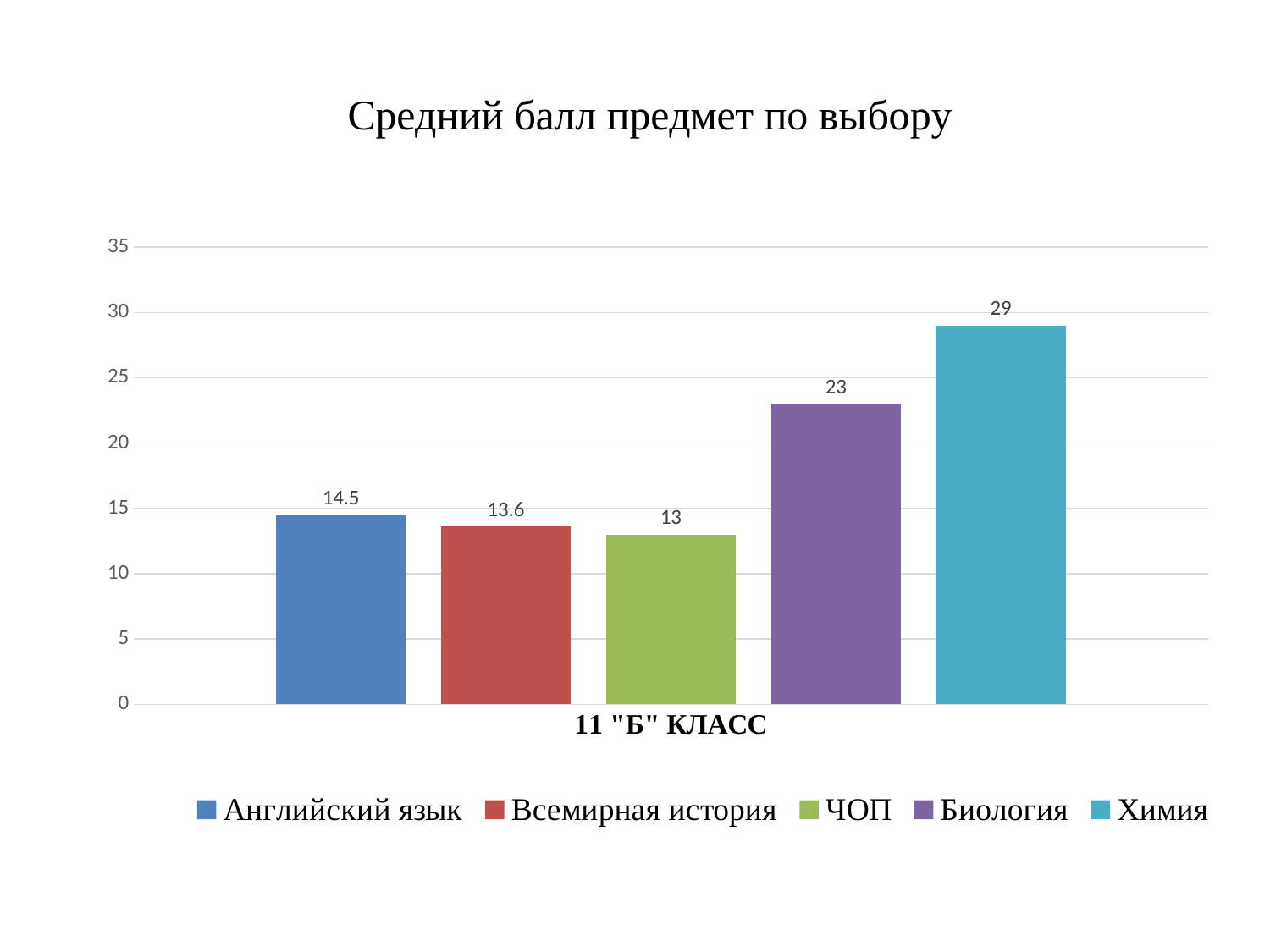
Which subject has the highest average score? Химия What is the average score for Английский язык? 14.5 What is the average score for Всемирная история? 13.6 What is the average score for Химия? 29 Is the value for Биология greater or less than 20? greater What kind of chart is shown on the slide? Bar chart Which subject has the lowest average score? ЧОП What is the title of the chart? Средний балл предмет по выбору What is the difference between the average scores for Химия and Биология? 6 Which has a higher average score, Английский язык or Всемирная история? Английский язык How many series does the legend list? 5 What is the average score for Биология? 23